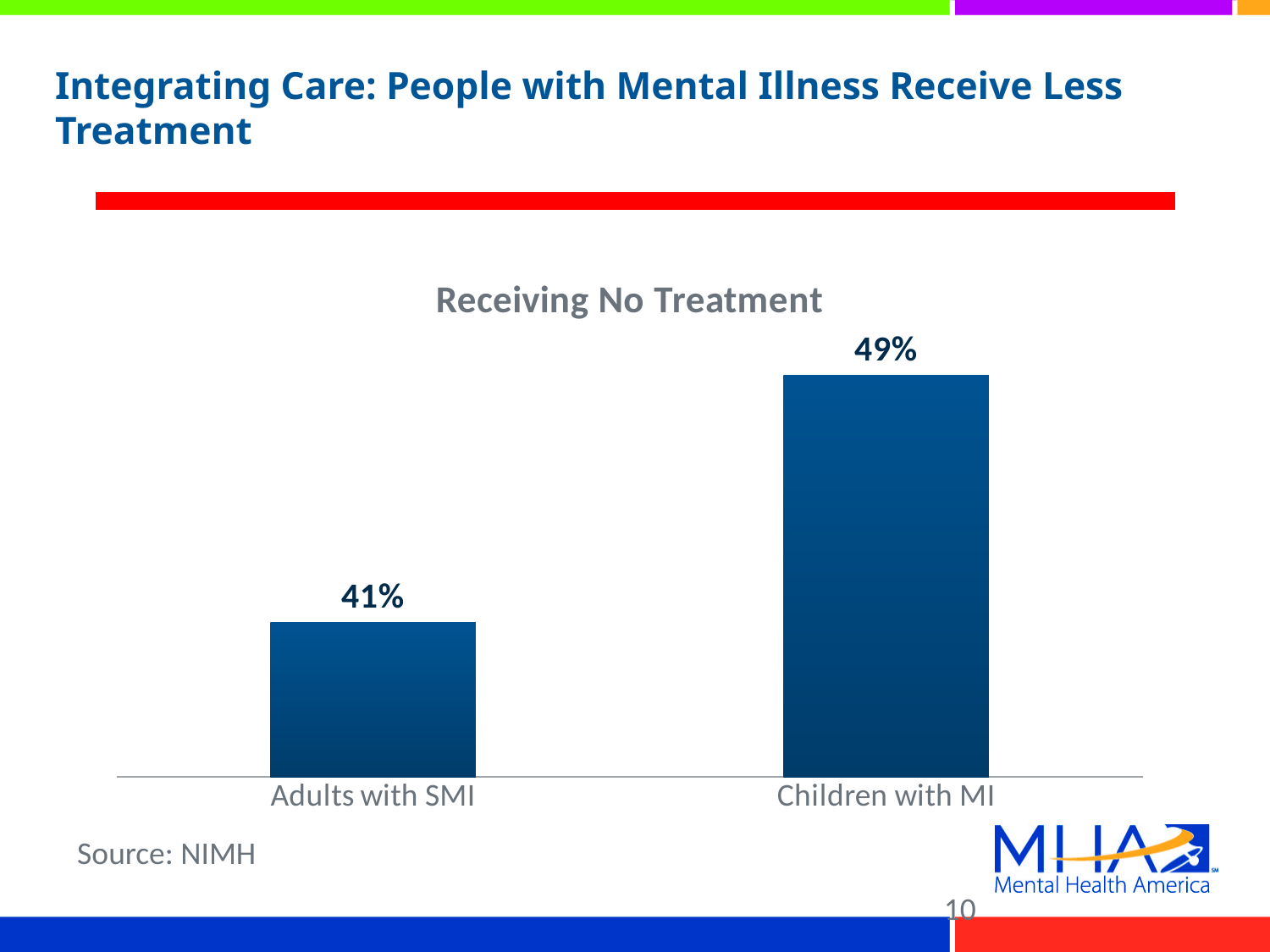
What percentage of Adults with SMI are receiving no treatment? 41% What source is cited for the chart data? NIMH What kind of chart is shown on the slide? Bar chart Which category has the lowest value in the Receiving No Treatment chart? Adults with SMI What percentage of Children with MI are receiving no treatment? 49% Which is larger: the value for Adults with SMI or the value for Children with MI? Children with MI What is the title of the chart? Receiving No Treatment Which category has the highest value in the Receiving No Treatment chart? Children with MI What is the difference between the values for Children with MI and Adults with SMI? 8% How many categories are shown in the chart? 2